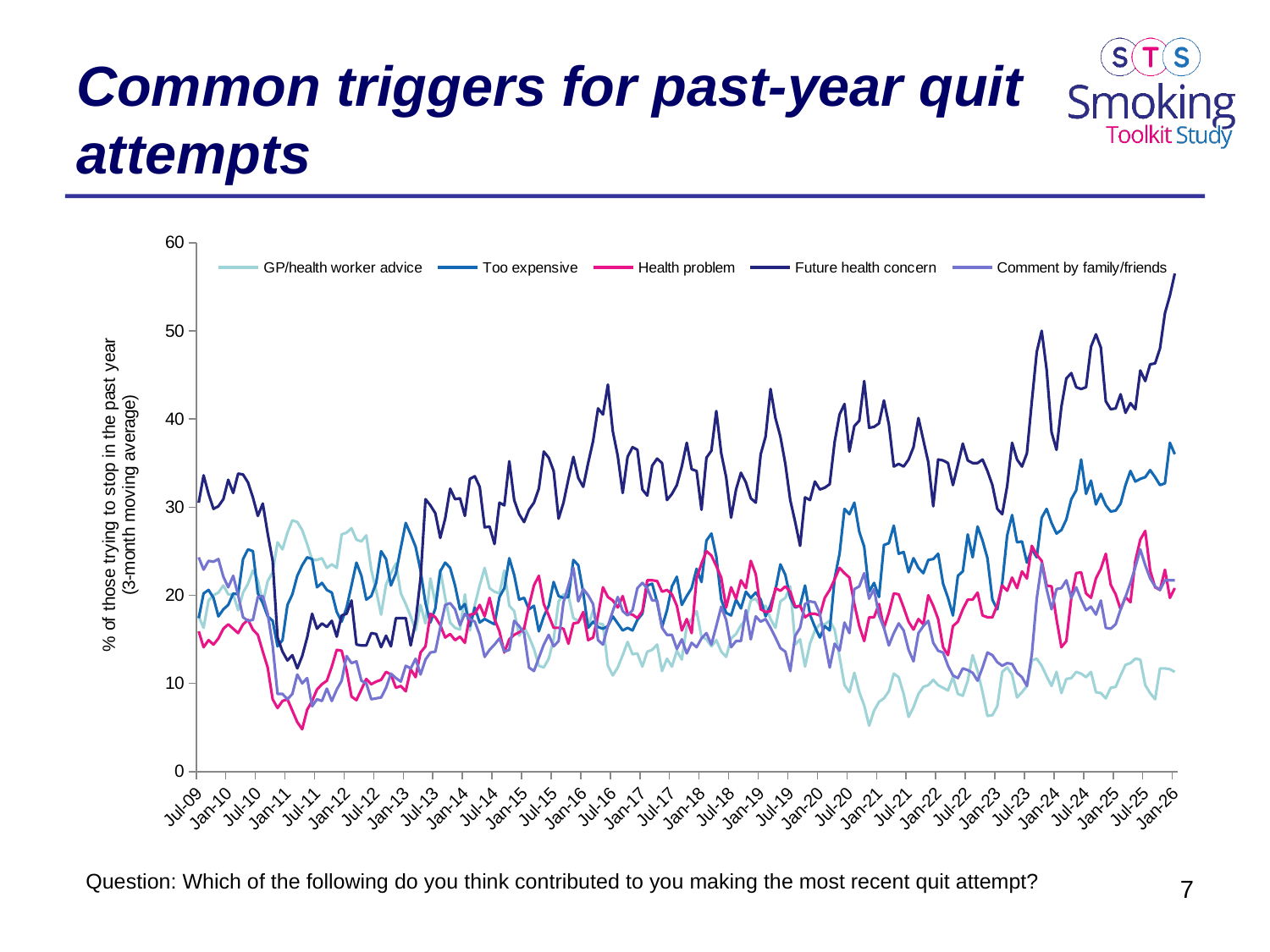
Does the Future health concern line rise or fall overall between Jan-23 and Jan-26? rise Which series is highest at Jan-26? Future health concern Which series is lowest at Jan-26? GP/health worker advice What are the five series listed in the legend? GP/health worker advice, Too expensive, Health problem, Future health concern, Comment by family/friends Is the value for GP/health worker advice at Jan-26 greater or less than 20? less At Jan-26, which is larger: Too expensive or Health problem? Too expensive How many series does the legend list? 5 Does the GP/health worker advice line rise or fall overall between Jul-09 and Jan-26? fall Is the value for Too expensive at Jan-26 greater or less than 30? greater Is the value for Future health concern at Jan-26 greater or less than 50? greater What is the label on the vertical axis? % of those trying to stop in the past year (3-month moving average) What kind of chart is shown on the slide? Line chart